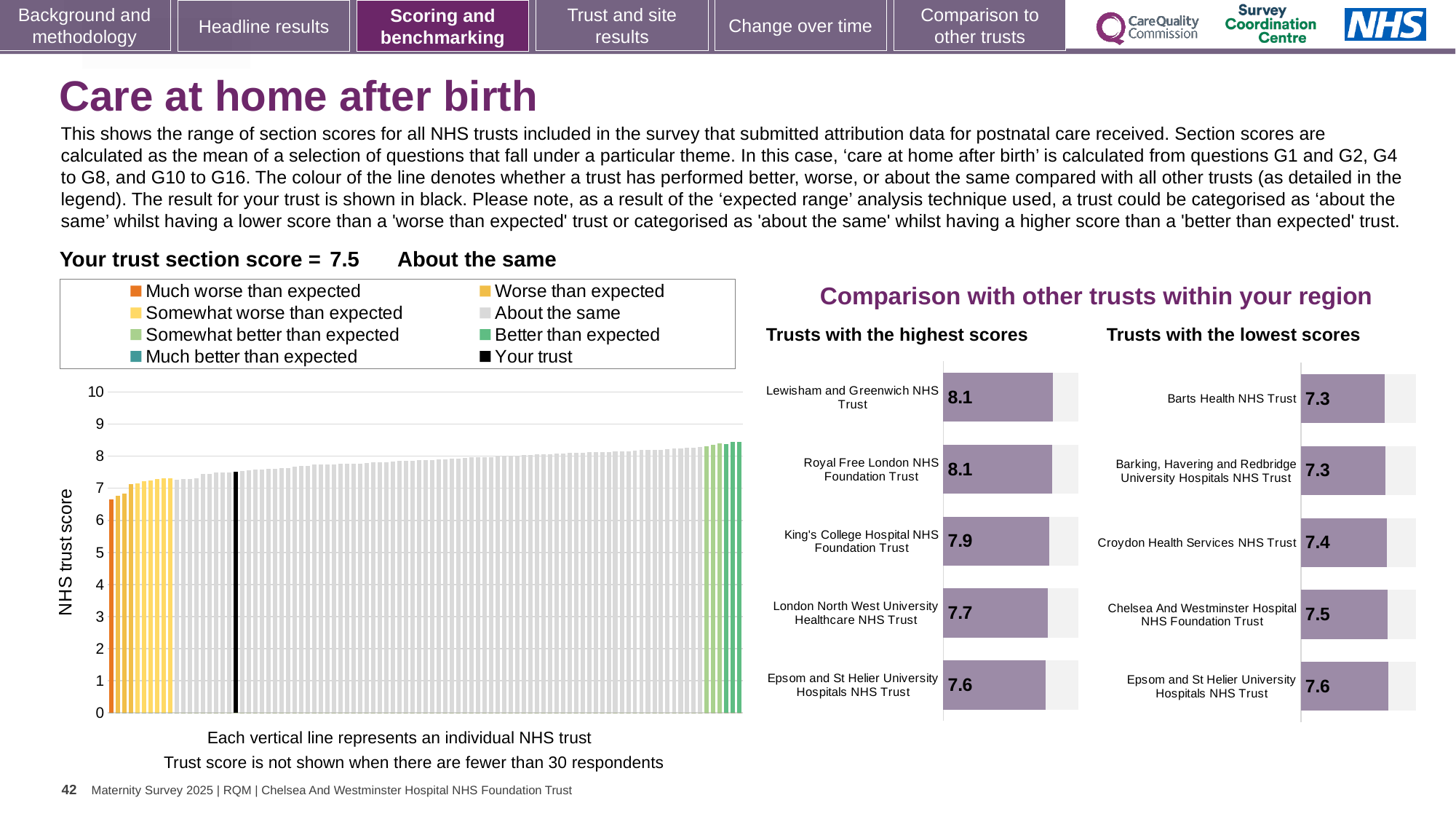
In the main 'NHS trust score' chart, what colour is the bar for your trust? Black In the 'Trusts with the highest scores' chart, what is the difference between the scores of Lewisham and Greenwich NHS Trust and Epsom and St Helier University Hospitals NHS Trust? 0.5 In the 'Trusts with the lowest scores' chart, what is the score for Barts Health NHS Trust? 7.3 What kind of chart is the main 'NHS trust score' chart on the left? Bar chart In the 'Trusts with the highest scores' chart, what is the score for King's College Hospital NHS Foundation Trust? 7.9 In the 'Trusts with the lowest scores' chart, what is the score for Croydon Health Services NHS Trust? 7.4 In the main 'NHS trust score' chart, do the values rise or fall from left to right? Rise How many trusts are listed in the 'Trusts with the highest scores' chart? 5 In the 'Trusts with the lowest scores' chart, which trust has the highest score? Epsom and St Helier University Hospitals NHS Trust In the 'Trusts with the highest scores' chart, which trust has the lowest score? Epsom and St Helier University Hospitals NHS Trust How many entries does the legend of the main 'NHS trust score' chart list? 8 Which has the higher score: London North West University Healthcare NHS Trust in the highest-scores chart or Chelsea And Westminster Hospital NHS Foundation Trust in the lowest-scores chart? London North West University Healthcare NHS Trust